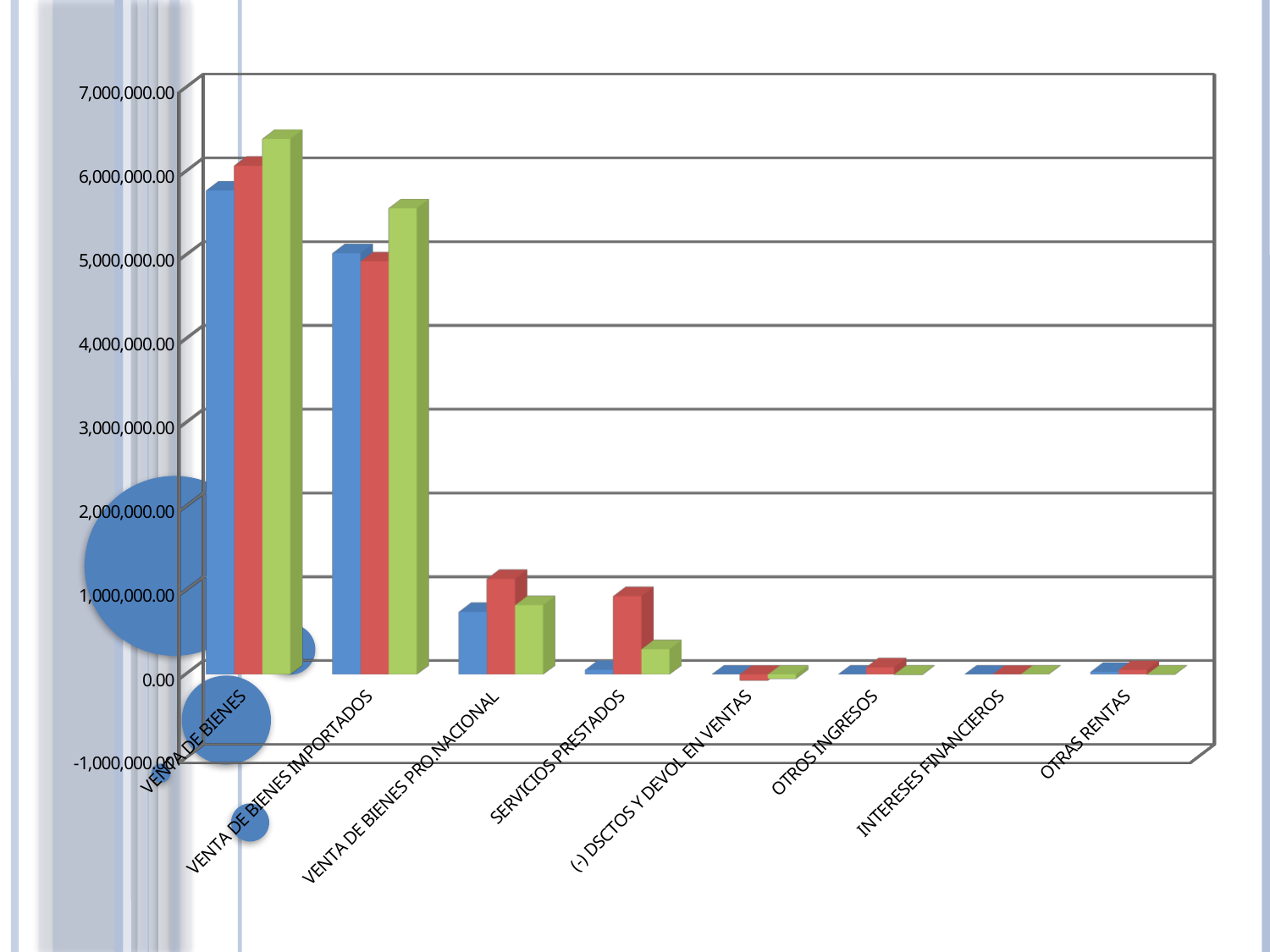
Within the VENTA DE BIENES category, which bar is taller, the blue bar or the green bar? green bar Is the value of the green bar for SERVICIOS PRESTADOS greater or less than 1,000,000.00? less Is the value of the red bar for VENTA DE BIENES PRO.NACIONAL greater or less than 1,000,000.00? greater Which category has the tallest bars in the chart? VENTA DE BIENES Is the value of the blue bar for VENTA DE BIENES greater or less than 6,000,000.00? less How many categories are shown on the x axis of the chart? 8 What is the lowest value shown on the vertical axis of the chart? -1,000,000.00 Within the SERVICIOS PRESTADOS category, which bar is taller, the red bar or the green bar? red bar What kind of chart is shown on the slide? bar chart What is the highest value shown on the vertical axis of the chart? 7,000,000.00